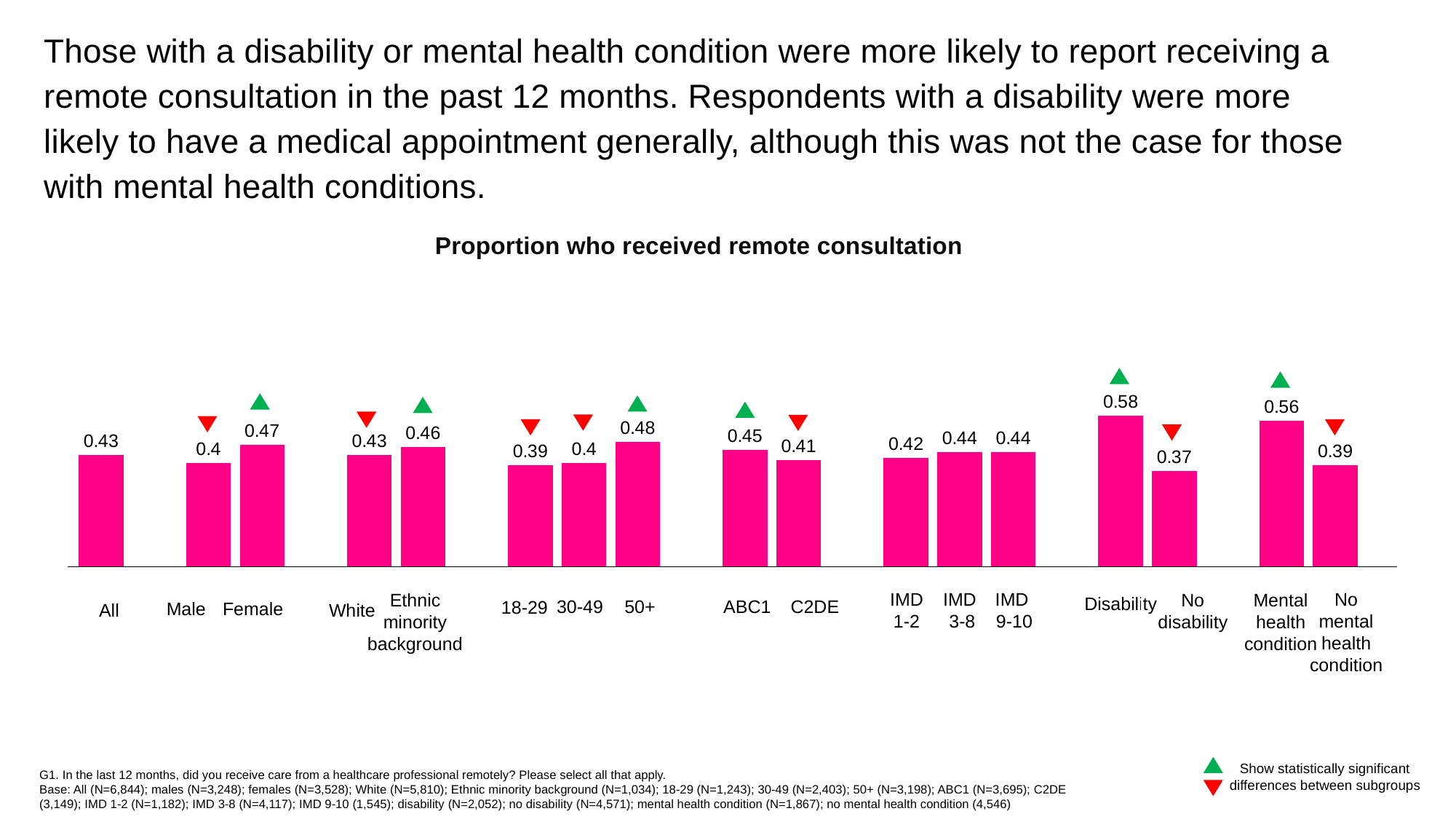
What is the title of the chart? Proportion who received remote consultation What is the value for Female? 0.47 What is the difference between the values for Disability and No disability? 0.21 What is the value for the 18-29 age group? 0.39 What is the value for Disability? 0.58 How many bars are shown in the chart? 17 Which category has the lowest value? No disability What is the difference between the values for Female and Male? 0.07 What kind of chart is shown? Bar chart Which is larger, the value for ABC1 or the value for C2DE? ABC1 What is the value for Ethnic minority background? 0.46 Which category has the highest value? Disability